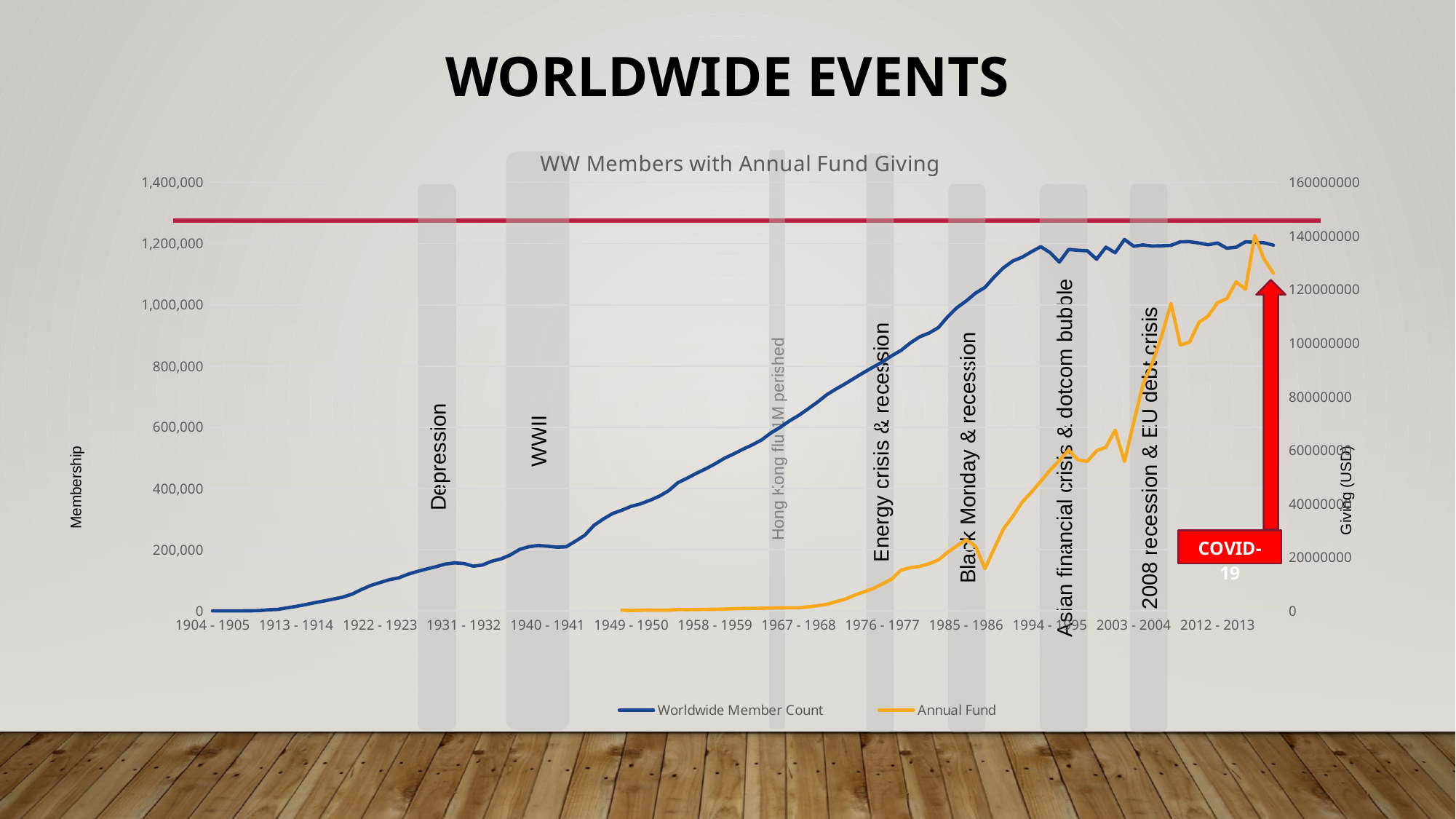
What is the title of the chart? WW Members with Annual Fund Giving Which series is drawn in orange according to the legend? Annual Fund Is the Worldwide Member Count for 1949 - 1950 greater or less than 400,000? less What kind of chart is shown on the slide? Line chart How many period labels are shown on the x axis? 13 Is the Annual Fund value for 2003 - 2004 greater or less than 40000000? greater Is the Worldwide Member Count for 1904 - 1905 greater or less than 200,000? less Does the Worldwide Member Count generally rise or fall from 1904 - 1905 to 2012 - 2013? rise Does the Annual Fund generally rise or fall from 1949 - 1950 to 2012 - 2013? rise How many series does the legend list? 2